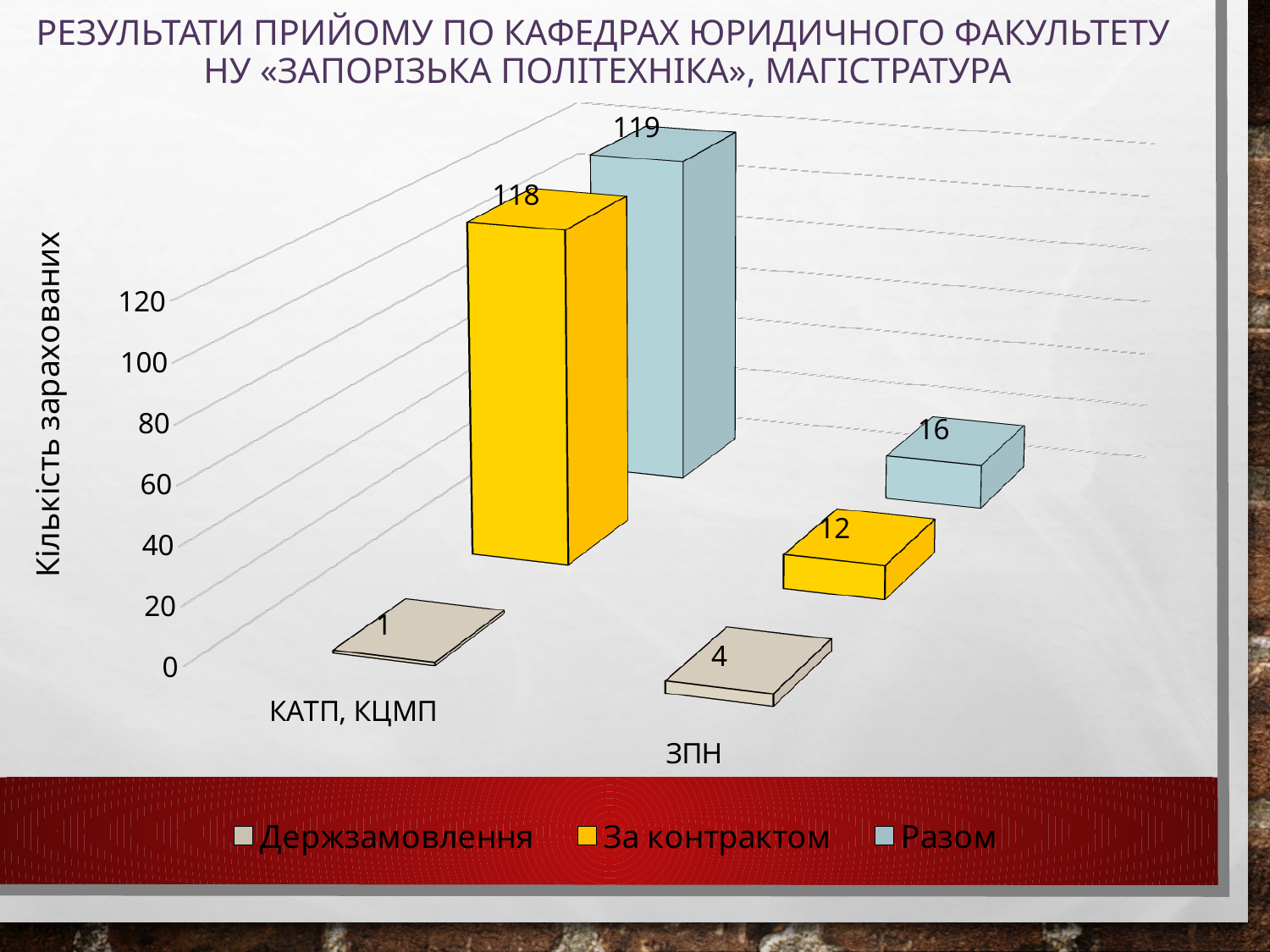
Which is larger: За контрактом for ЗПН or Разом for ЗПН? Разом for ЗПН Is the Разом value for КАТП, КЦМП greater or less than 100? greater How many categories are shown on the x axis? 2 How many series does the legend list? 3 What is the value of Держзамовлення for КАТП, КЦМП? 1 What kind of chart is shown on the slide? bar chart What is the difference between the За контрактом values for КАТП, КЦМП and ЗПН? 106 What is the value of Держзамовлення for ЗПН? 4 What is the value of За контрактом for КАТП, КЦМП? 118 Which category has the lowest Держзамовлення value? КАТП, КЦМП What is the value of Разом for ЗПН? 16 Which category has the highest Разом value? КАТП, КЦМП